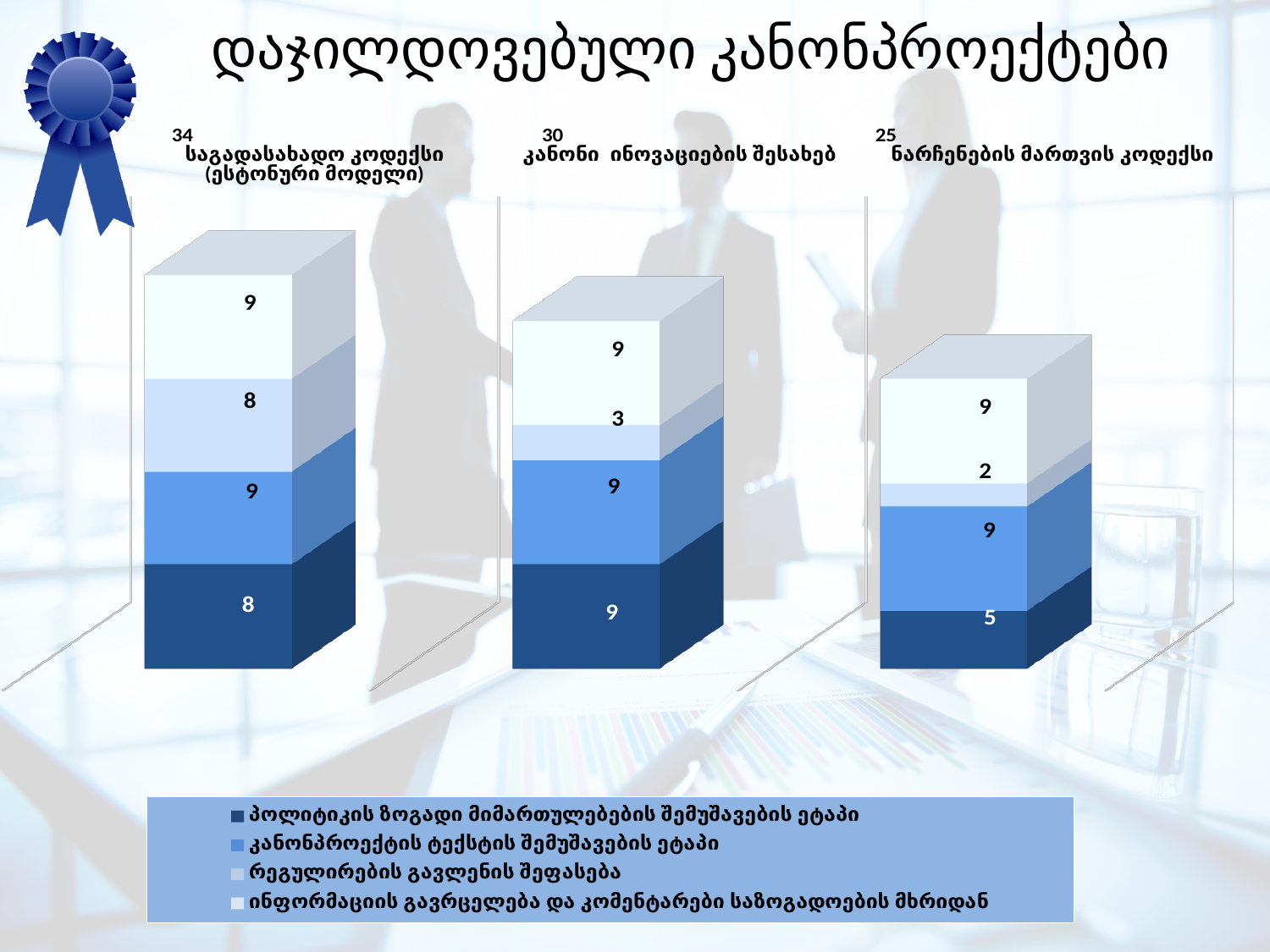
What is the value of the პოლიტიკის ზოგადი მიმართულებების შემუშავების ეტაპი segment for ნარჩენების მართვის კოდექსი? 5 Which category has the lowest total? ნარჩენების მართვის კოდექსი How many categories (bars) does the chart show? 3 Which category has the highest total? საგადასახადო კოდექსი (ესტონური მოდელი) What is the total shown above the bar for საგადასახადო კოდექსი (ესტონური მოდელი)? 34 What is the total shown above the bar for ნარჩენების მართვის კოდექსი? 25 What kind of chart is shown on the slide? stacked bar chart How many series does the legend list? 4 What is the title of the slide? დაჯილდოვებული კანონპროექტები Which is larger: the რეგულირების გავლენის შეფასება segment for საგადასახადო კოდექსი (ესტონური მოდელი) or for ნარჩენების მართვის კოდექსი? საგადასახადო კოდექსი (ესტონური მოდელი) What is the difference between the totals of კანონი ინოვაციების შესახებ and ნარჩენების მართვის კოდექსი? 5 What is the value of the რეგულირების გავლენის შეფასება segment for კანონი ინოვაციების შესახებ? 3